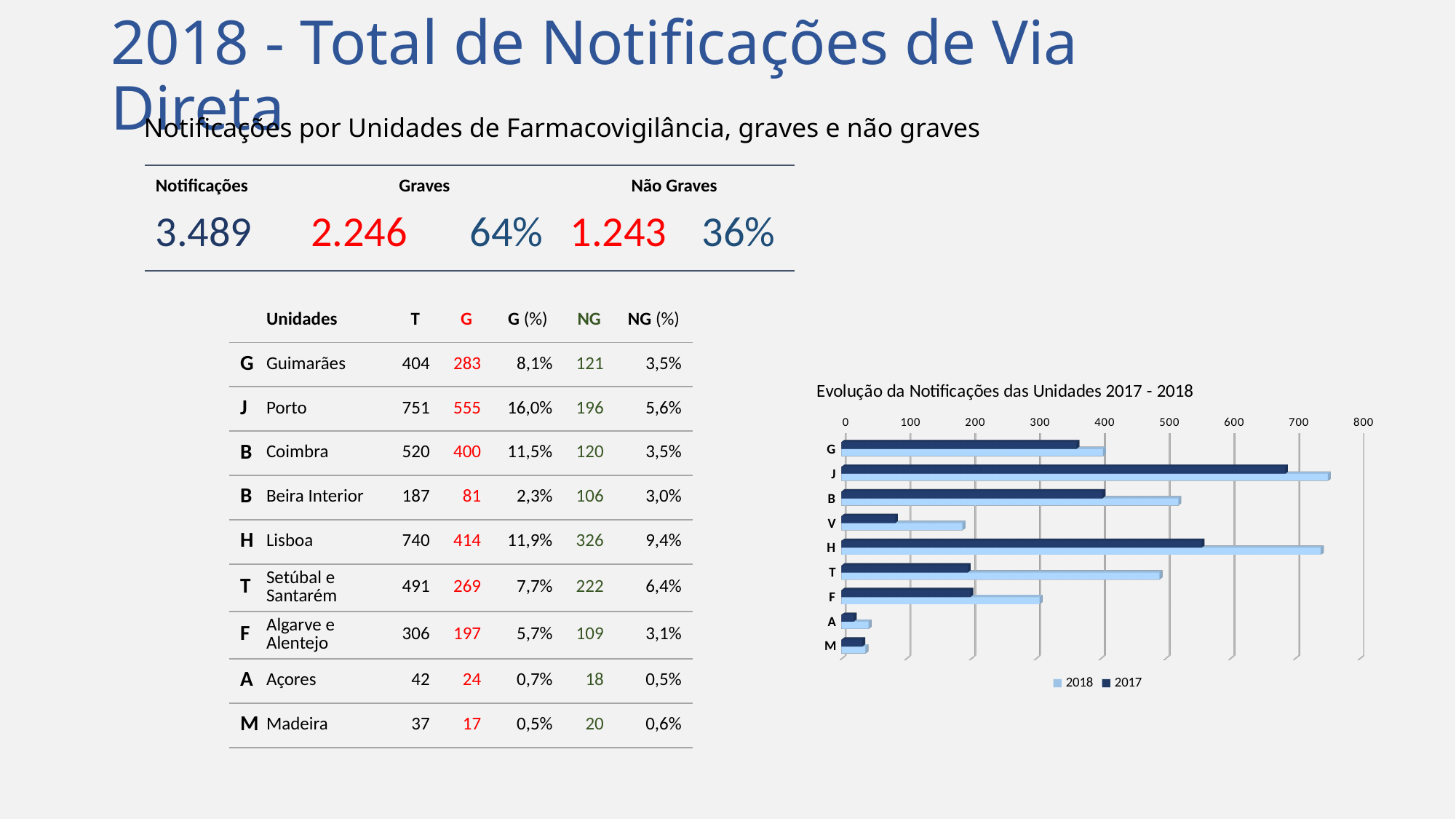
Which series is shown in the darker blue colour in the chart? 2017 What is the title of the chart on the slide? Evolução da Notificações das Unidades 2017 - 2018 In the chart, which is larger for the 2017 series: J or H? J Is the 2018 value for J in the chart greater or less than 700? greater Is the 2017 value for H in the chart greater or less than 500? greater Is the 2018 value for A in the chart greater or less than 100? less What kind of chart is shown on the slide? bar chart In the chart, which is larger for V: the 2018 value or the 2017 value? 2018 How many categories are shown on the chart's vertical axis? 9 Which category has the highest value for the 2017 series in the chart? J How many series does the chart's legend list? 2